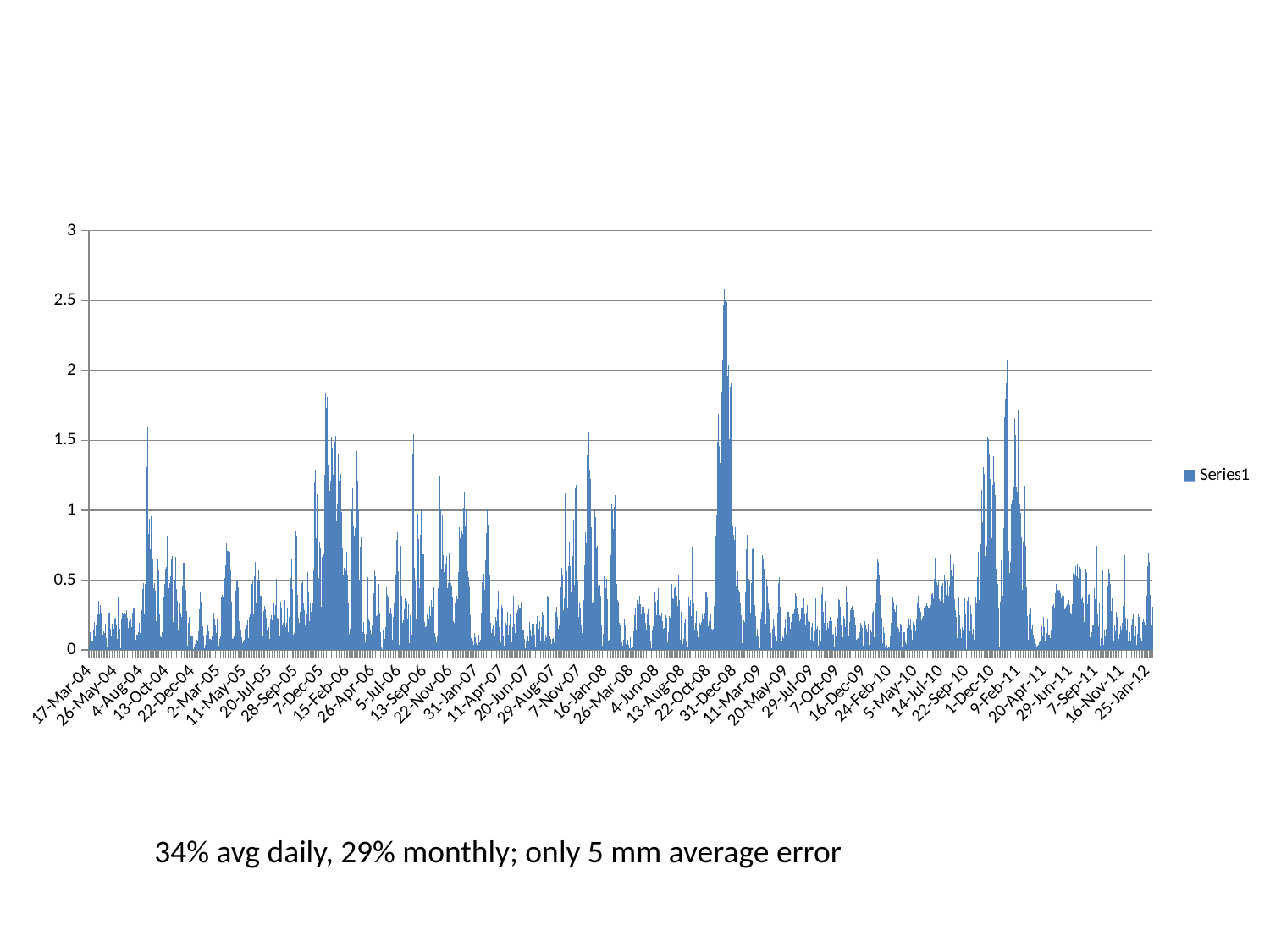
Is the tallest spike near 4-Aug-04 greater or less than 2? less Is the tallest spike near 15-Feb-06 greater or less than 1.5? greater Is the tallest spike in the chart, near 31-Dec-08, greater or less than 2.5? greater How many series does the legend list? 1 Around which x-axis date label does the highest spike in the chart occur? 31-Dec-08 What kind of chart is shown on the slide? bar chart Which is taller: the highest spike near 31-Dec-08 or the highest spike near 9-Feb-11? 31-Dec-08 What is the name of the series shown in the legend? Series1 What is the highest value shown on the vertical axis? 3 Which is taller: the highest spike near 15-Feb-06 or the highest spike near 29-Jul-09? 15-Feb-06